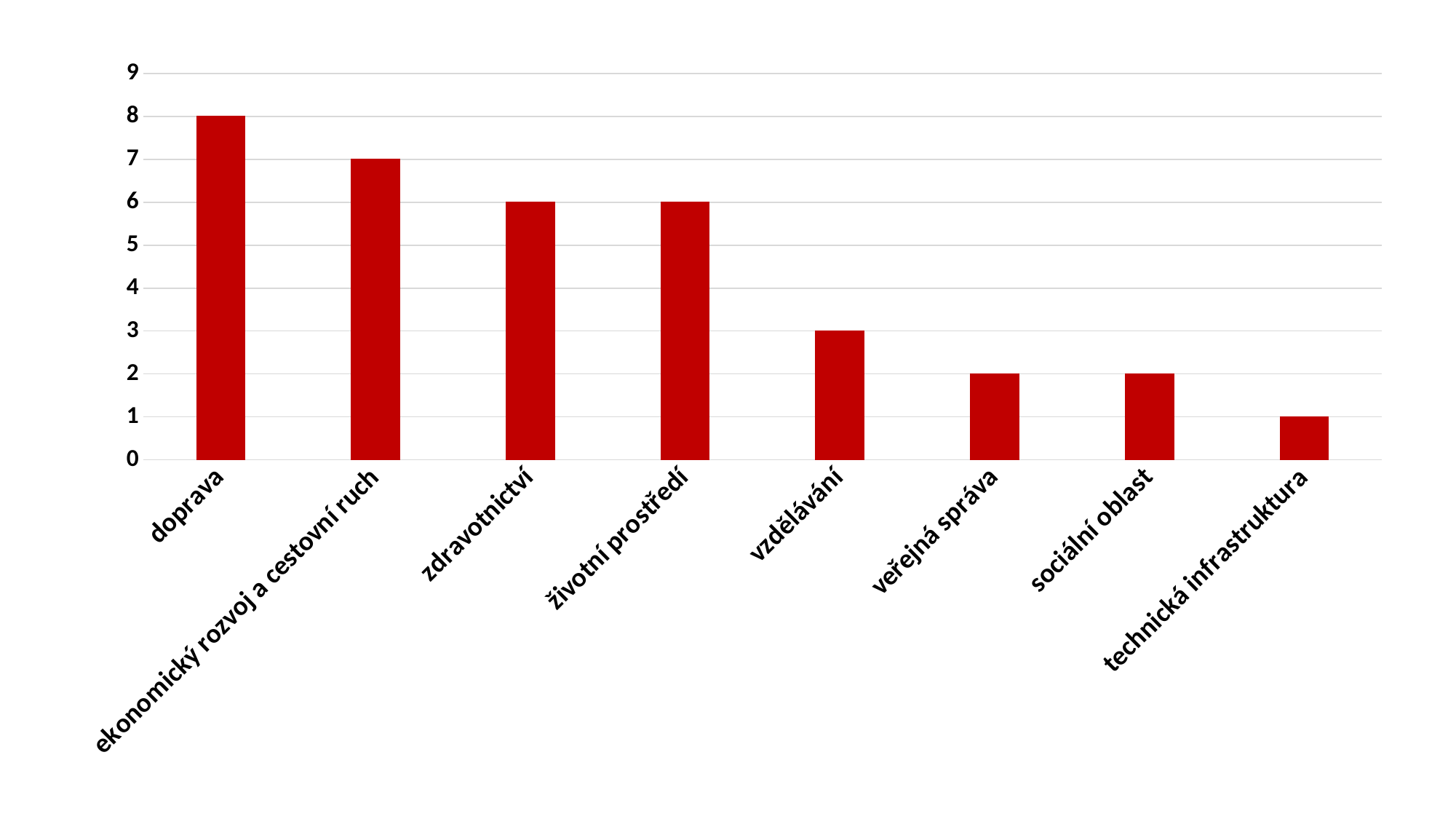
Which is larger, the value for zdravotnictví or the value for veřejná správa? zdravotnictví Which category has the lowest value? technická infrastruktura What is the value for vzdělávání? 3 Is the value for životní prostředí greater or less than 5? greater What kind of chart is this? bar chart What is the value for doprava? 8 What is the value for technická infrastruktura? 1 How many categories are shown on the x axis? 8 Which category has the highest value? doprava Do the values rise or fall from left to right along the x axis? fall What is the difference between the values for doprava and vzdělávání? 5 What is the value for ekonomický rozvoj a cestovní ruch? 7